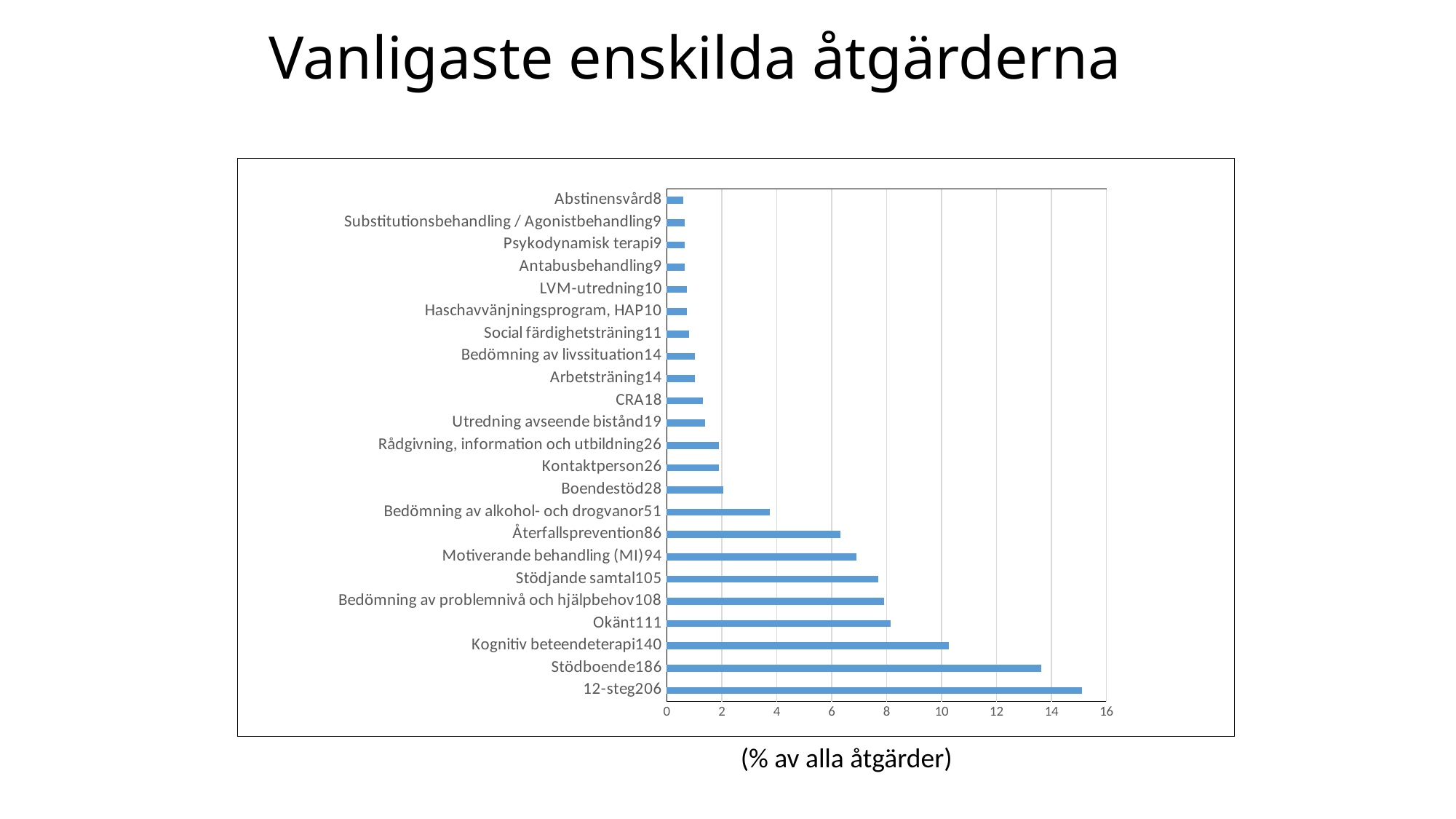
Is the value for Okänt111 greater or less than 10? less Is the value for Stödboende186 greater or less than 14? less Which category has the longest bar? 12-steg206 What kind of chart is shown on the slide? bar chart Which has the larger value, Kognitiv beteendeterapi140 or Okänt111? Kognitiv beteendeterapi140 Is the value for 12-steg206 greater or less than 14? greater Which has the larger value, Stödboende186 or Återfallsprevention86? Stödboende186 What is the title of the slide above the chart? Vanligaste enskilda åtgärderna How many categories (bars) does the chart show? 23